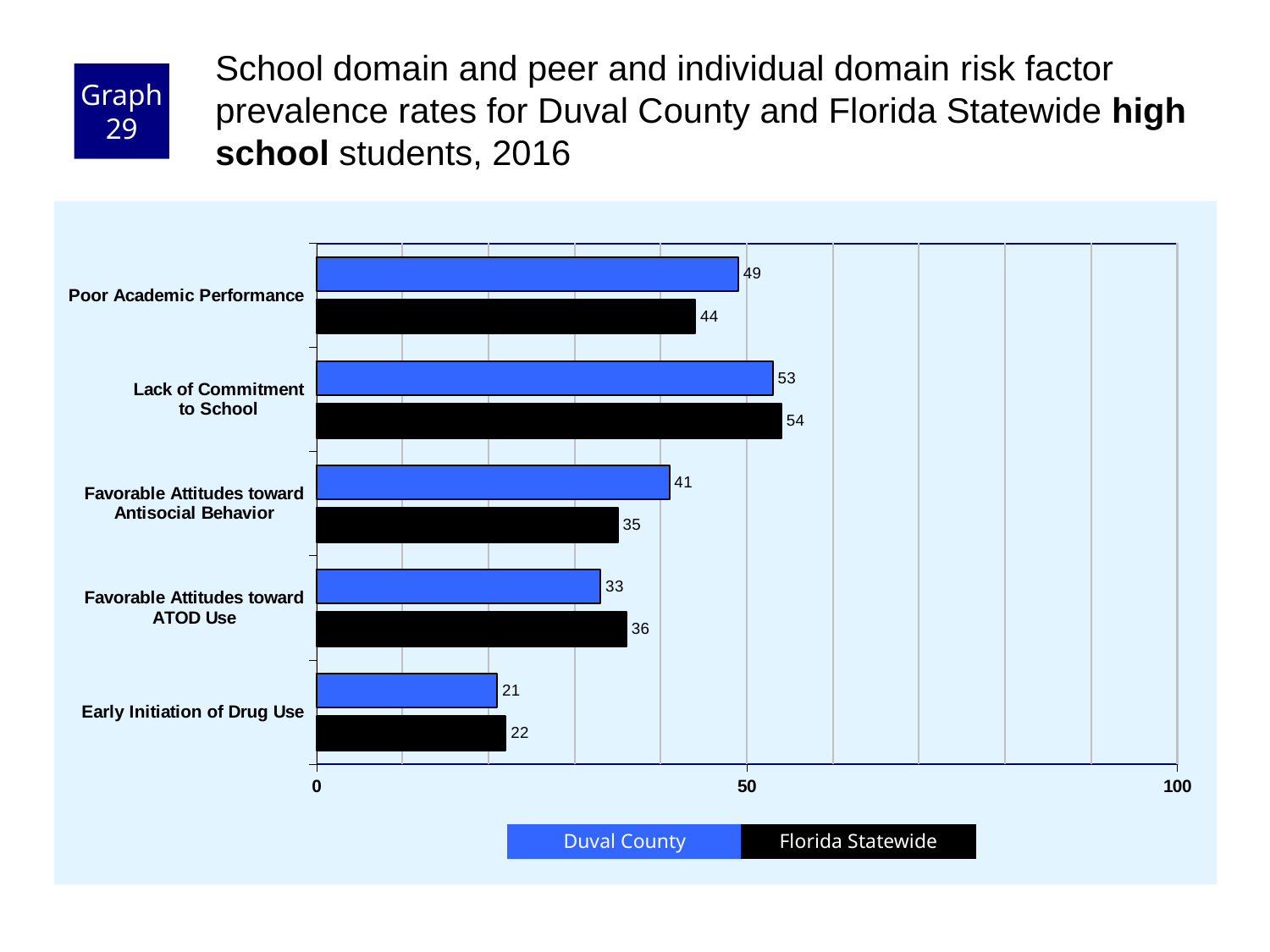
What is the difference between the Duval County and Florida Statewide values for Poor Academic Performance? 5 What is the Duval County value for Poor Academic Performance? 49 Which risk factor has the lowest Florida Statewide value? Early Initiation of Drug Use How many series does the legend list? 2 What is the Duval County value for Early Initiation of Drug Use? 21 For Favorable Attitudes toward ATOD Use, which is larger: Duval County or Florida Statewide? Florida Statewide What is the Florida Statewide value for Favorable Attitudes toward ATOD Use? 36 What is the difference between the Duval County and Florida Statewide values for Favorable Attitudes toward Antisocial Behavior? 6 Which risk factor has the highest Duval County value? Lack of Commitment to School How many risk factor categories are shown in the chart? 5 Is the Florida Statewide value for Lack of Commitment to School greater or less than 50? greater What kind of chart is shown on the slide? Bar chart